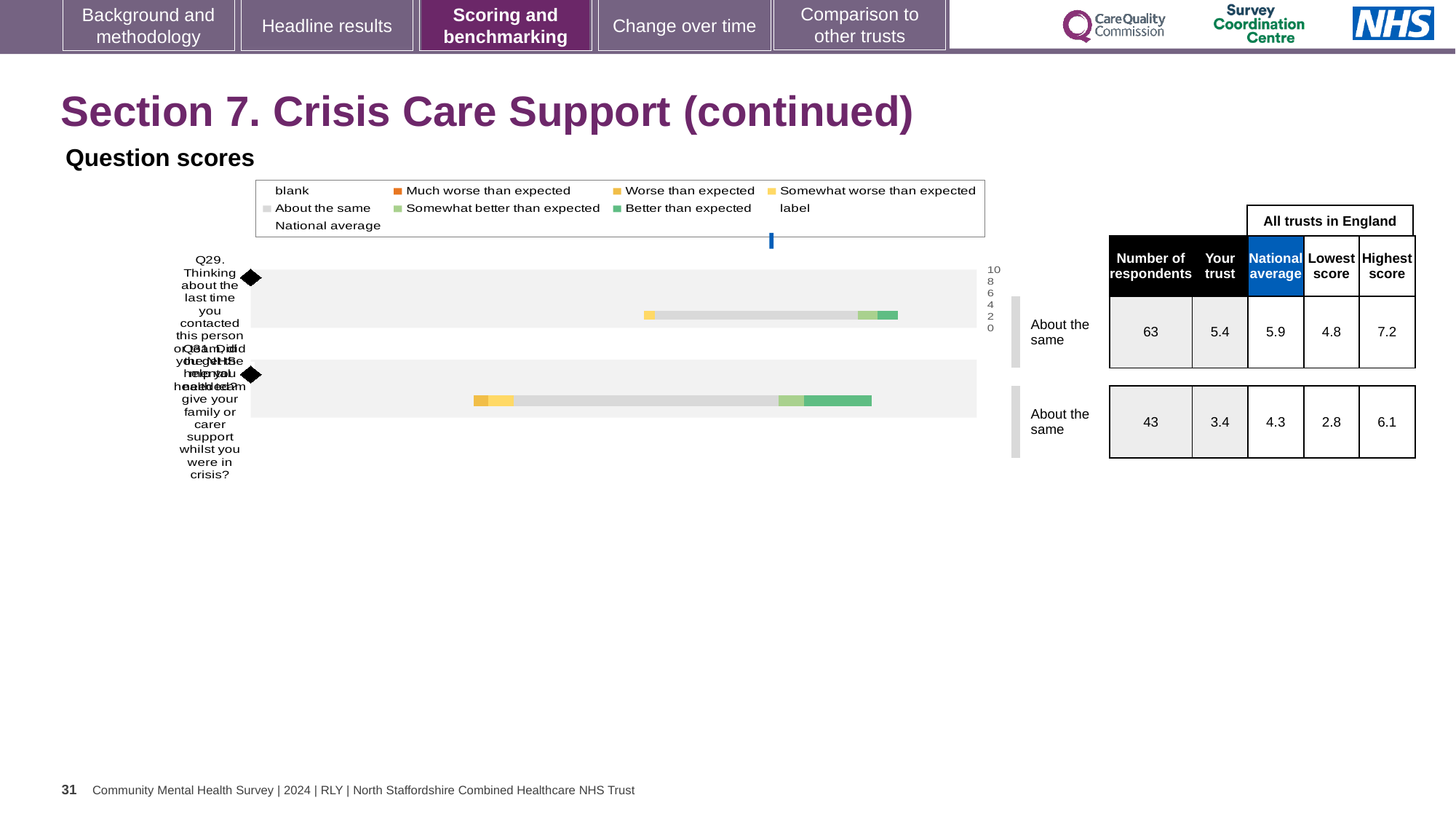
In the table beside the chart, how many respondents are listed for Q29? 63 In the table beside the chart, which question has the higher "Your trust" score, Q29 or Q31? Q29 How many entries does the legend of the question scores chart list? 9 In the table beside the chart, what is the lowest score across all trusts in England for Q31? 2.8 In the table beside the chart, what is the "Your trust" score for Q31? 3.4 In the legend of the question scores chart, what colour represents "Much worse than expected"? orange In the table beside the chart, what is the difference between the national average and the "Your trust" score for Q29? 0.5 What kind of chart is used to show the question scores? bar chart How many questions (bars) are plotted in the question scores chart? 2 In the legend of the question scores chart, what colour represents "About the same"? grey In the table beside the chart, which question has the higher "Highest score" value? Q29 What benchmark category is shown next to the bar for Q29? About the same